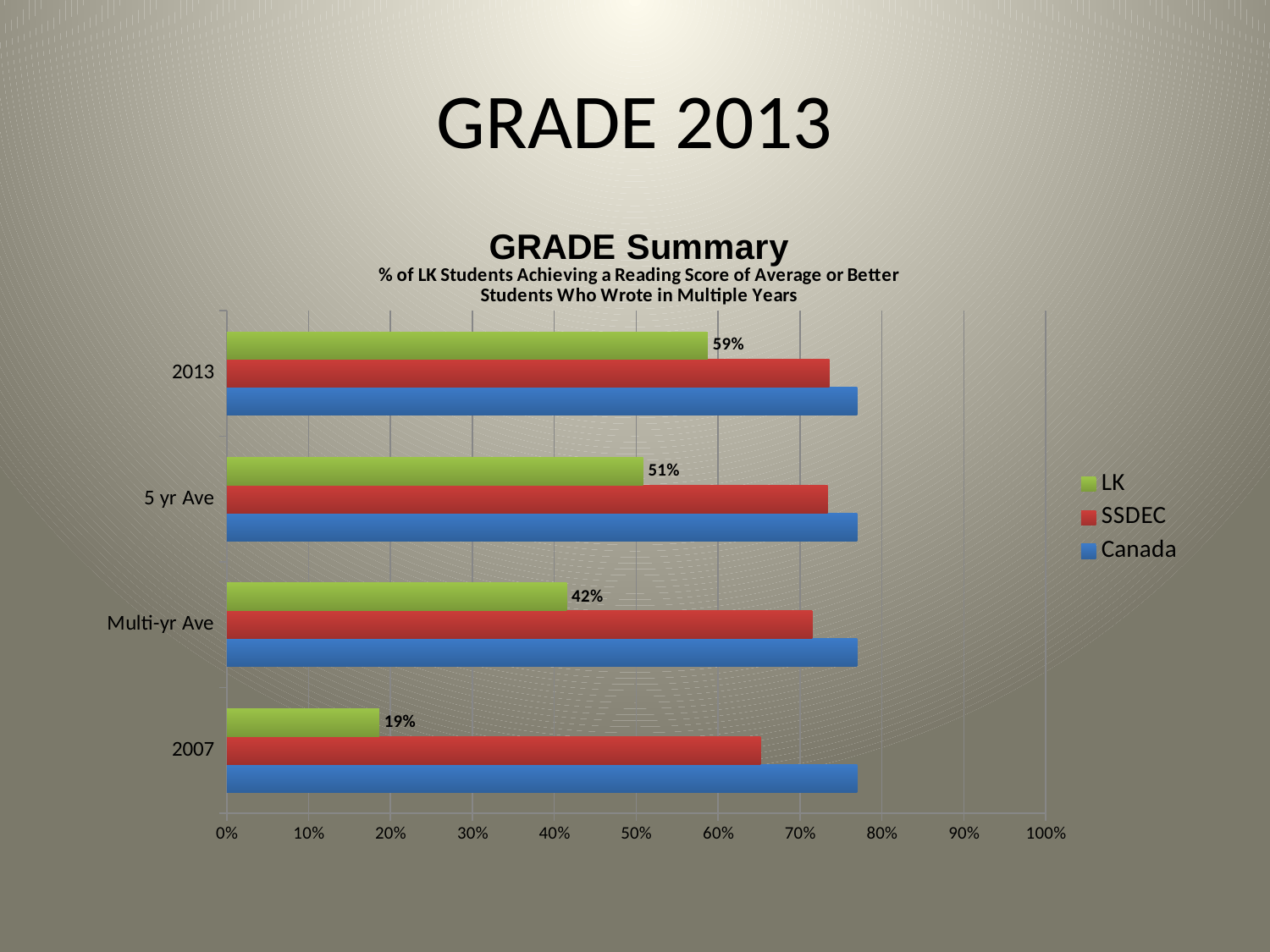
What is the difference between the LK value for 2013 and the LK value for 2007? 40% How many series does the legend list? 3 What is the LK value for 2007? 19% How many categories are shown on the vertical axis of the chart? 4 What kind of chart is shown on the slide? Bar chart Which category has the highest LK value? 2013 Which is larger, the LK value for 5 yr Ave or the LK value for Multi-yr Ave? 5 yr Ave Is the SSDEC value for 2007 greater or less than 60%? greater What is the LK value for 2013 in the GRADE Summary chart? 59% Which category has the lowest LK value? 2007 What is the LK value for the Multi-yr Ave category? 42% Is the Canada value for 2013 greater or less than 80%? less